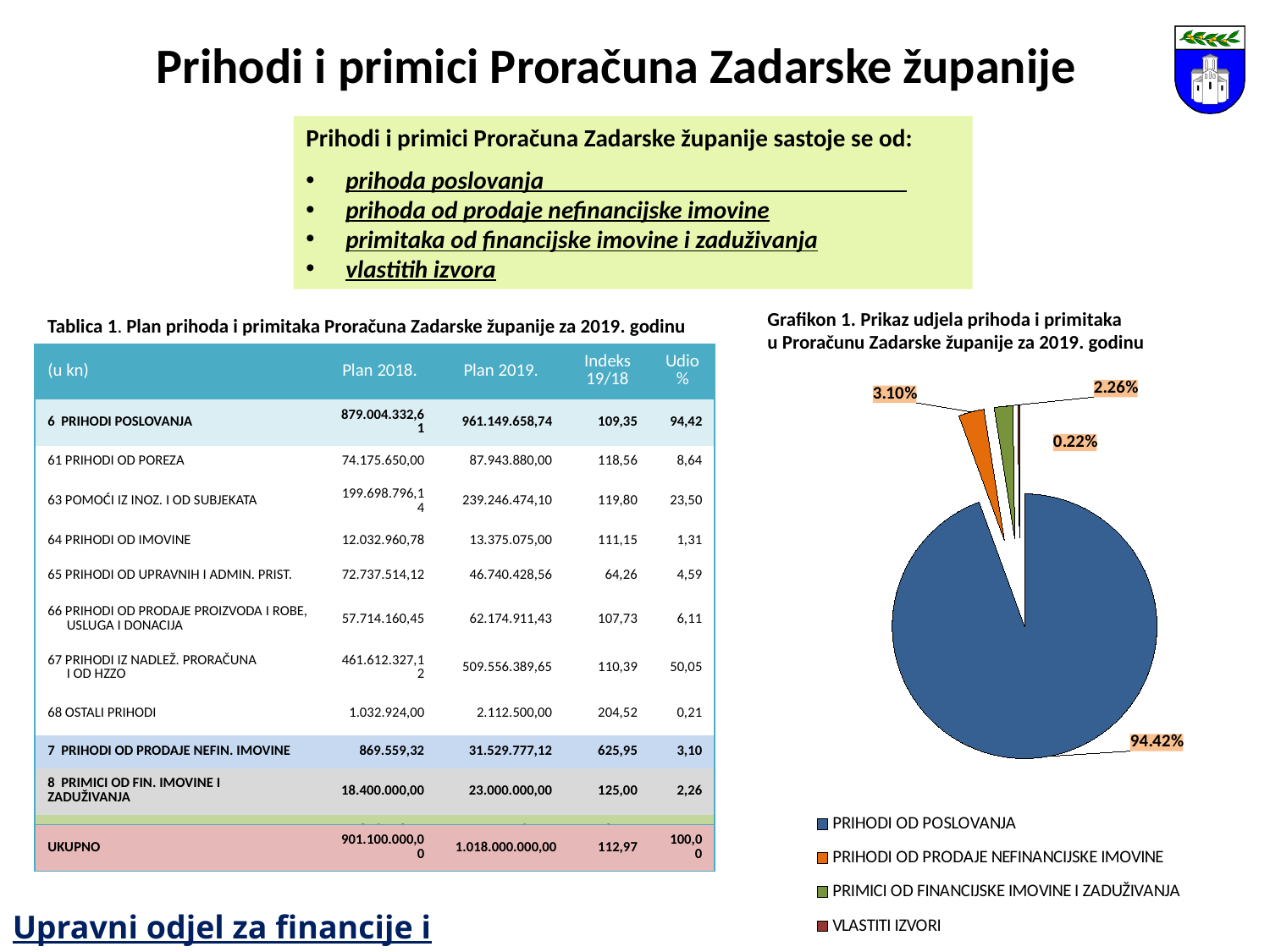
What colour is the PRIHODI OD POSLOVANJA slice in the pie chart? blue What share of the pie chart does VLASTITI IZVORI have? 0.22% How many entries does the legend of the pie chart list? 4 What is the difference in percentage points between the shares of PRIHODI OD PRODAJE NEFINANCIJSKE IMOVINE and PRIMICI OD FINANCIJSKE IMOVINE I ZADUŽIVANJA? 0.84 What share of the pie chart does PRIHODI OD PRODAJE NEFINANCIJSKE IMOVINE have? 3.10% What kind of chart is shown on the slide? pie chart What share of the pie chart does PRIHODI OD POSLOVANJA have? 94.42% Which slice is larger: PRIHODI OD PRODAJE NEFINANCIJSKE IMOVINE or PRIMICI OD FINANCIJSKE IMOVINE I ZADUŽIVANJA? PRIHODI OD PRODAJE NEFINANCIJSKE IMOVINE How many slices does the pie chart have? 4 Which category has the smallest slice in the pie chart? VLASTITI IZVORI Which category has the largest slice in the pie chart? PRIHODI OD POSLOVANJA